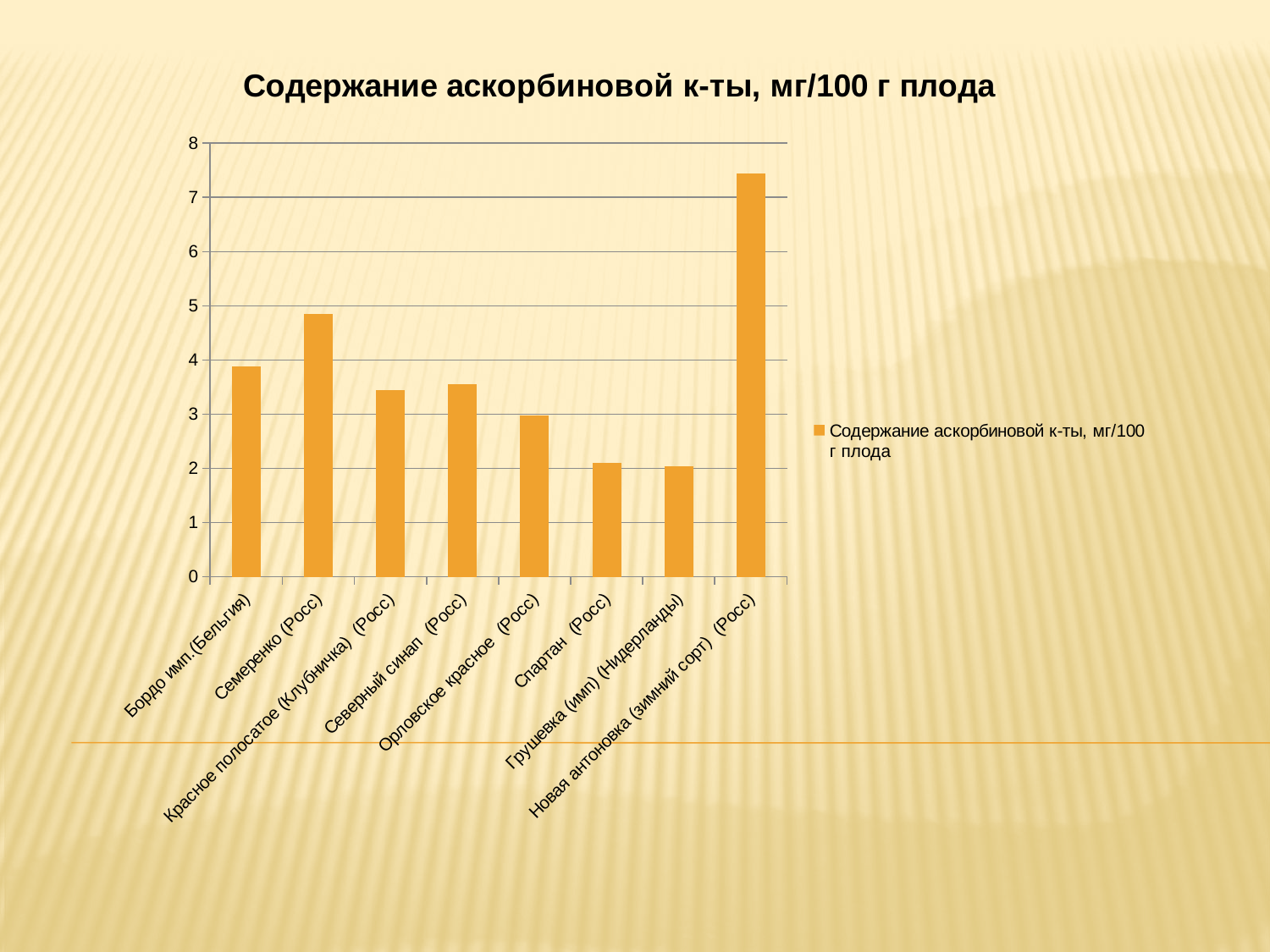
How many apple varieties (categories) are plotted on the chart? 8 Which has a higher value, Семеренко (Росс) or Бордо имп.(Бельгия)? Семеренко (Росс) Is the value for Новая антоновка (зимний сорт) (Росс) greater or less than 7? greater What kind of chart is shown on the slide? bar chart Which variety has the highest ascorbic acid content? Новая антоновка (зимний сорт) (Росс) How many series does the legend list? 1 Is the value for Семеренко (Росс) greater or less than 4? greater Is the value for Спартан (Росс) greater or less than 3? less Which has a higher value, Орловское красное (Росс) or Грушевка (имп) (Нидерланды)? Орловское красное (Росс) What is the title of the chart? Содержание аскорбиновой к-ты, мг/100 г плода